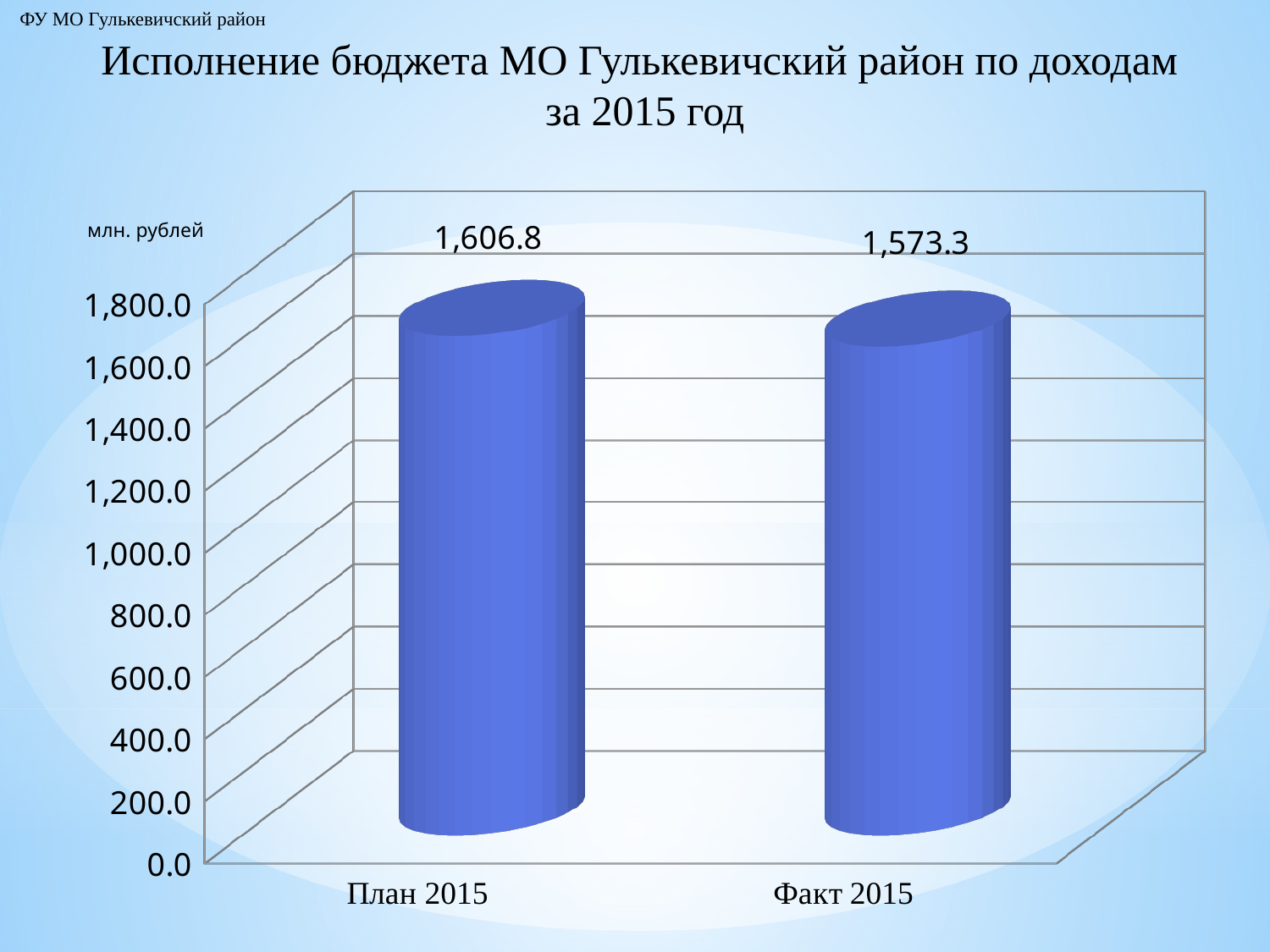
What unit of measurement is indicated for the values on the chart? млн. рублей Is the value for План 2015 greater or less than 1,800.0? less Which category has the lowest value? Факт 2015 Which is larger, the value for План 2015 or the value for Факт 2015? План 2015 What is the value for Факт 2015? 1,573.3 Which category has the highest value? План 2015 What is the title of the chart? Исполнение бюджета МО Гулькевичский район по доходам за 2015 год How many categories are shown on the x axis? 2 Is the value for Факт 2015 greater or less than 1,400.0? greater What is the value for План 2015? 1,606.8 What is the difference between the values for План 2015 and Факт 2015? 33.5 What kind of chart is shown on the slide? bar chart